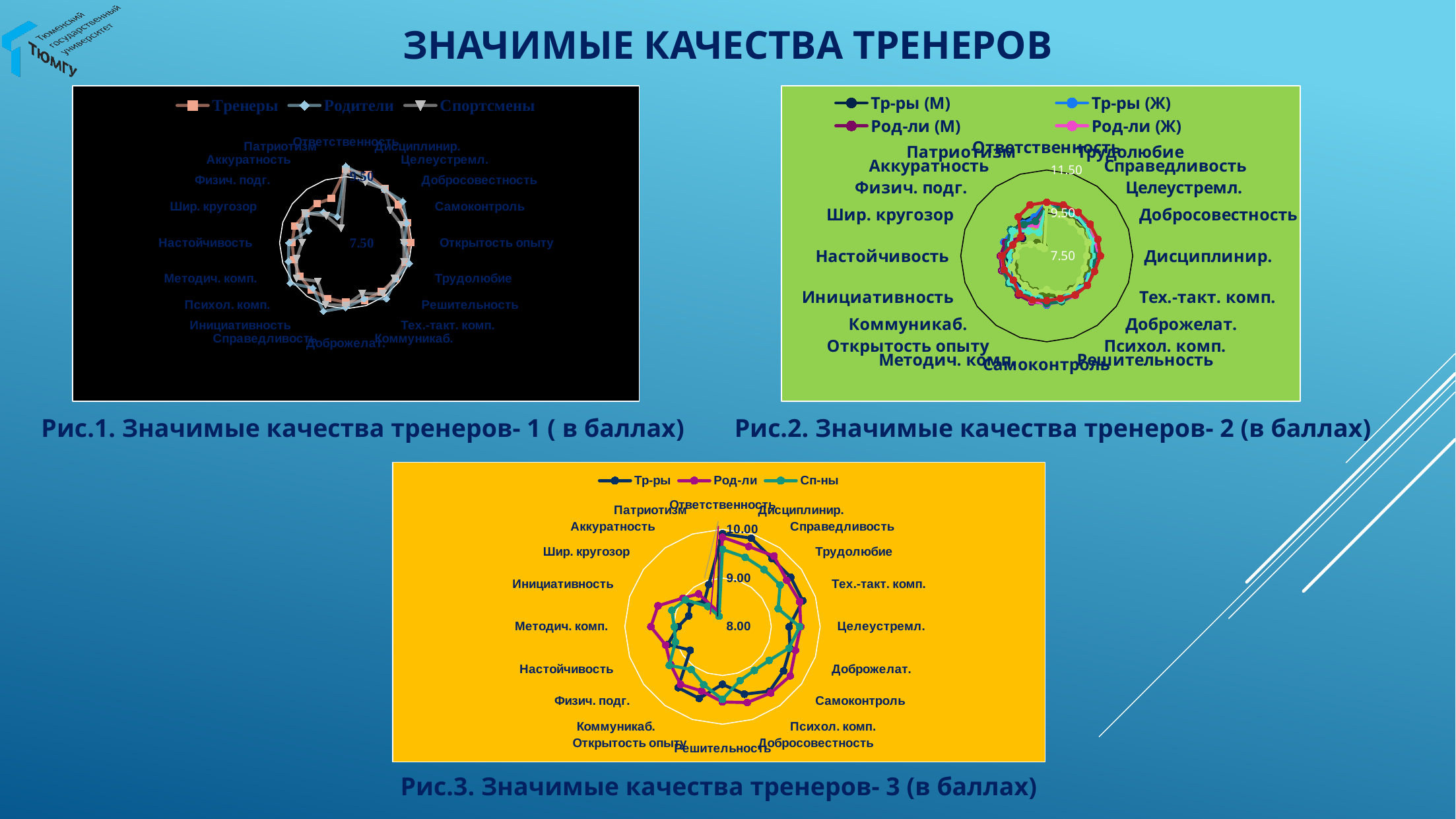
What kind of chart is Рис.3 (the chart on the orange background)? radar chart How many series does the legend of Рис.2 (the chart on the green background) list? 4 Which series are listed in the legend of Рис.1 (the chart on the black background)? Тренеры, Родители, Спортсмены What kind of chart is Рис.1 (the chart on the black background)? radar chart In Рис.3 (the chart on the orange background), is the value for Род-ли at Методич. комп. greater or less than 9.00? greater How many categories are plotted around Рис.3 (the chart on the orange background)? 20 How many categories are plotted around Рис.2 (the chart on the green background)? 20 Which series are listed in the legend of Рис.2 (the chart on the green background)? Тр-ры (М), Тр-ры (Ж), Род-ли (М), Род-ли (Ж) How many series does the legend of Рис.1 (the chart on the black background) list? 3 How many categories (qualities) are plotted around Рис.1 (the chart on the black background)? 20 How many series does the legend of Рис.3 (the chart on the orange background) list? 3